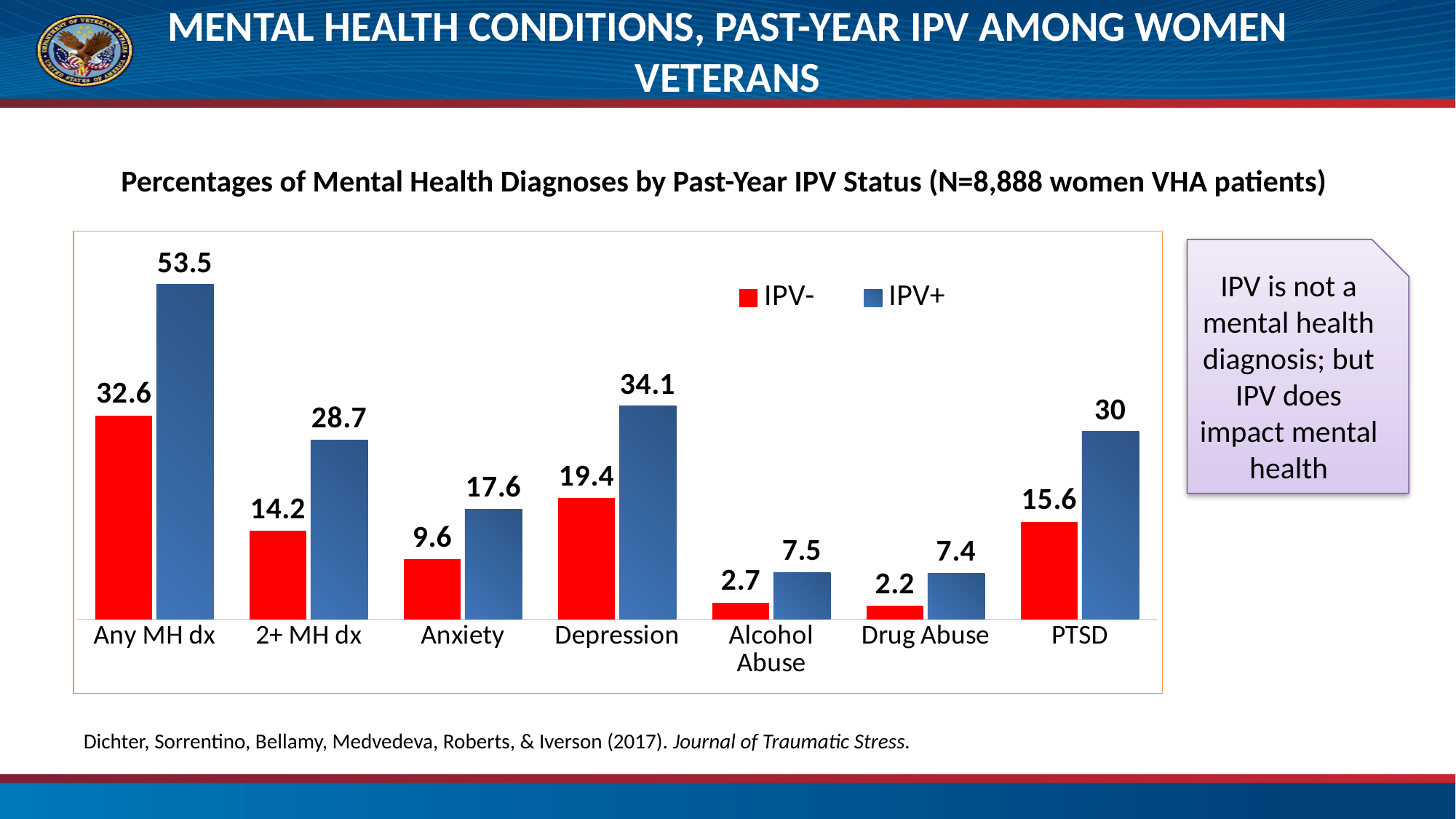
What kind of chart is shown on the slide? Bar chart Which category has the highest IPV+ value? Any MH dx Which is larger, the IPV+ value for Depression or the IPV+ value for PTSD? Depression What is the IPV- value for Depression? 19.4 What is the IPV- value for Drug Abuse? 2.2 What is the IPV+ value for PTSD? 30 What is the difference between the IPV+ and IPV- values for Anxiety? 8 How many series does the legend list? 2 What is the IPV+ value for Any MH dx? 53.5 What is the difference between the IPV+ and IPV- values for 2+ MH dx? 14.5 Which category has the lowest IPV- value? Drug Abuse How many categories are shown on the x axis? 7